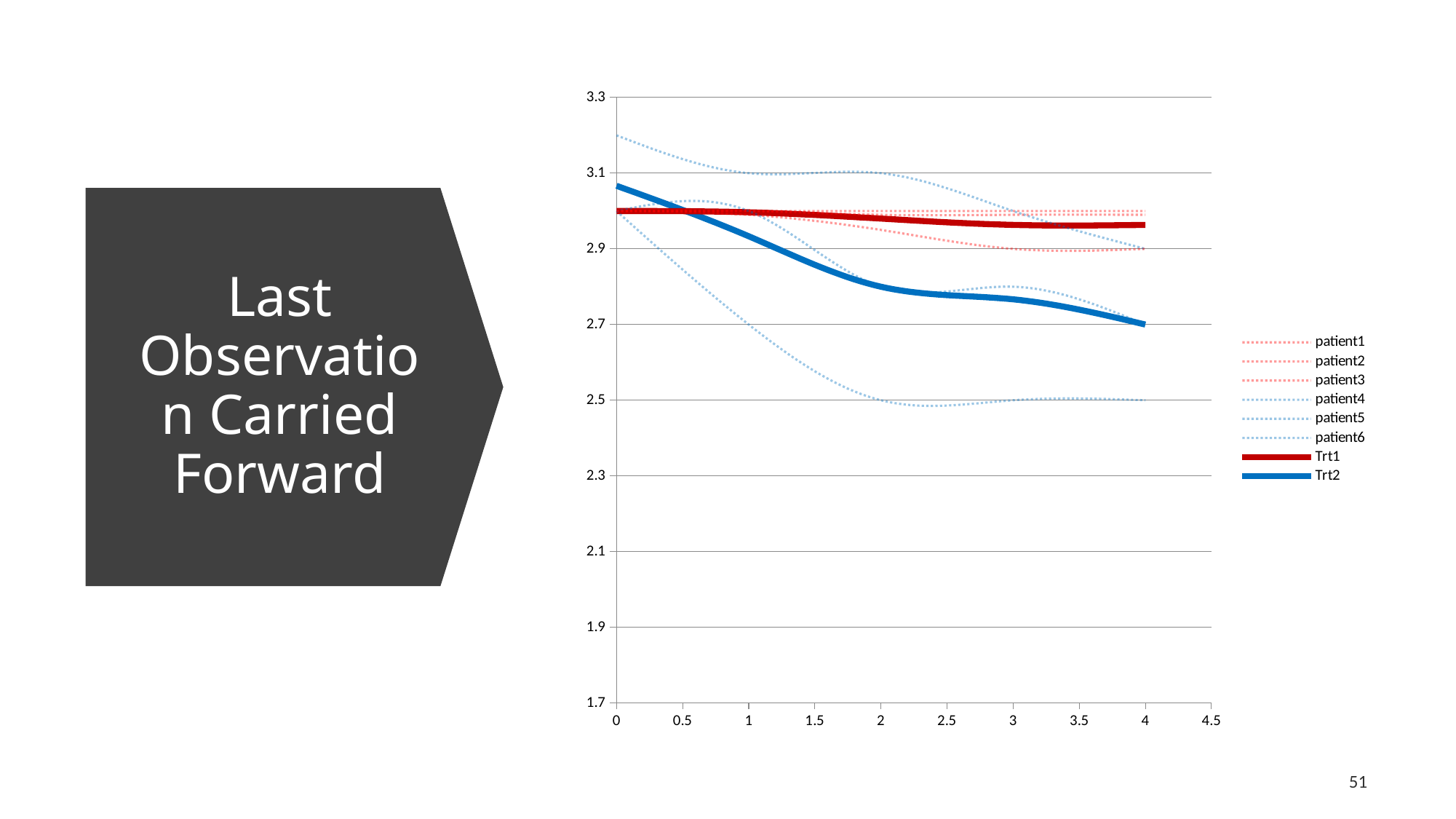
At x = 4, which is larger, Trt1 or Trt2? Trt1 Is the value of Trt1 at x = 4 greater or less than 2.9? greater Which series is drawn as a thick solid red line? Trt1 Is the value of patient4 at x = 0 greater or less than 3.1? greater Does the Trt2 line rise or fall as x increases from 0 to 4? fall Is the value of patient6 at x = 2 greater or less than 2.7? less Which series has the highest value at x = 0? patient4 Which series is drawn as a thick solid blue line? Trt2 What kind of chart is shown on the slide? line chart Which series has the lowest value at x = 4? patient6 How many series does the chart's legend list? 8